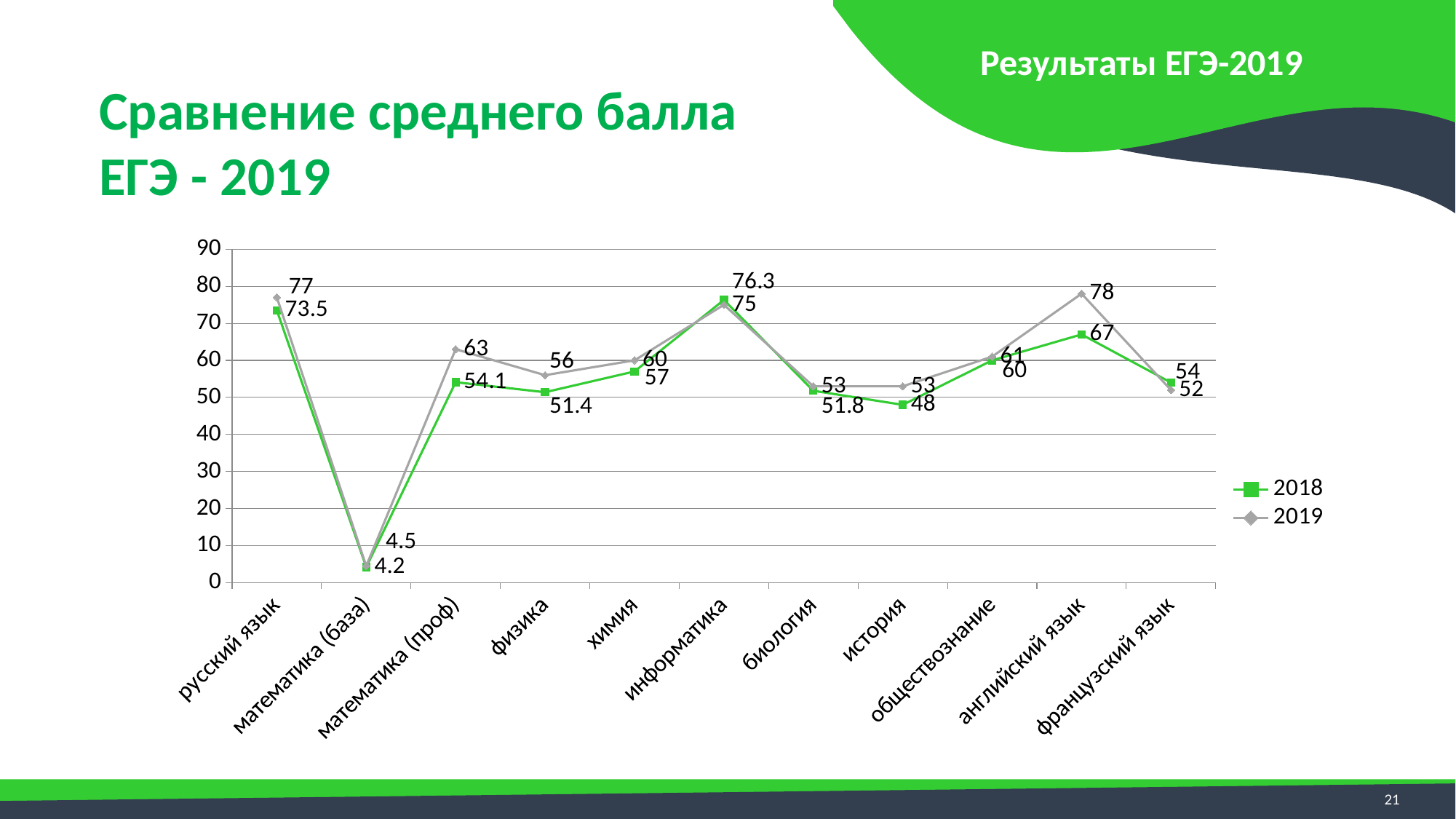
How many series does the legend list? 2 What is the 2018 value for информатика? 76.3 What type of chart is shown on the slide? line chart How many subject categories are plotted on the x axis? 11 Which series is drawn in green? 2018 What is the 2018 value for математика (проф)? 54.1 For французский язык, which series has the larger value, 2018 or 2019? 2018 Which subject has the lowest 2018 value? математика (база) What is the difference between the 2019 and 2018 values for математика (проф)? 8.9 Which subject has the highest 2019 value? английский язык What is the 2019 value for английский язык? 78 What is the difference between the 2019 and 2018 values for английский язык? 11